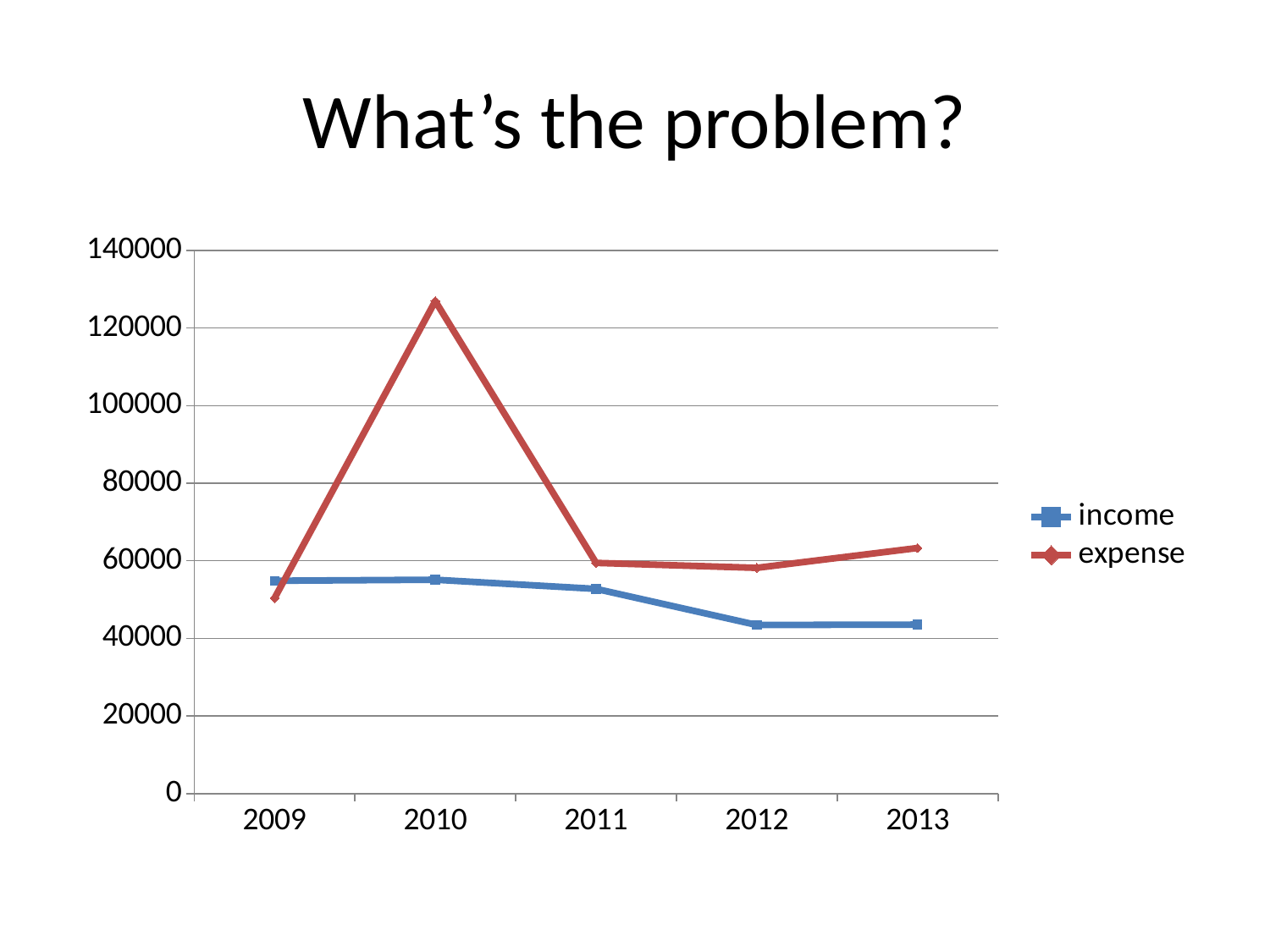
Is the expense value for 2010 greater or less than 120000? greater How many years are plotted along the x axis? 5 In which year is expense lowest? 2009 What are the two entries in the legend? income, expense How many series does the legend list? 2 Does income rise or fall from 2009 to 2013? fall In which year is expense highest? 2010 What is the title of the slide? What's the problem? What kind of chart is shown on the slide? line chart In 2009, which is larger, income or expense? income In 2010, which is larger, income or expense? expense Is the income value for 2013 greater or less than 60000? less